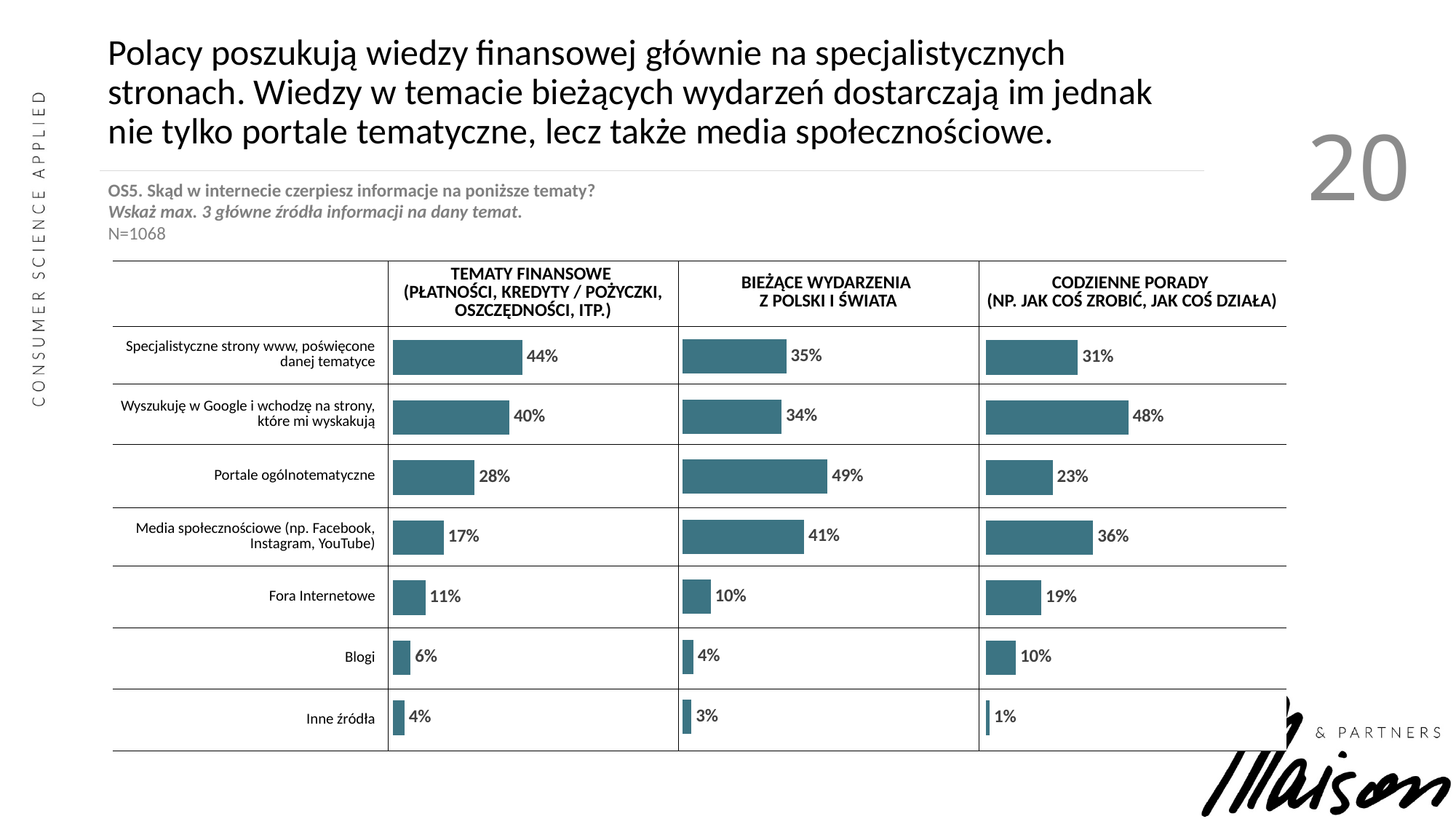
In the CODZIENNE PORADY chart, which is larger: Wyszukuję w Google i wchodzę na strony, które mi wyskakują or Specjalistyczne strony www? Wyszukuję w Google i wchodzę na strony, które mi wyskakują In the TEMATY FINANSOWE chart, what is the value for Specjalistyczne strony www, poświęcone danej tematyce? 44% What is the sample size (N) stated on the slide? N=1068 In the BIEŻĄCE WYDARZENIA Z POLSKI I ŚWIATA chart, which category has the highest value? Portale ogólnotematyczne How many categories are shown in each of the three charts? 7 In the TEMATY FINANSOWE chart, which category has the highest value? Specjalistyczne strony www, poświęcone danej tematyce In the CODZIENNE PORADY chart, what is the value for Fora Internetowe? 19% In the BIEŻĄCE WYDARZENIA Z POLSKI I ŚWIATA chart, what is the value for Media społecznościowe (np. Facebook, Instagram, YouTube)? 41% In the CODZIENNE PORADY chart, which category has the lowest value? Inne źródła What kind of chart is used in the TEMATY FINANSOWE column? Bar chart In the BIEŻĄCE WYDARZENIA Z POLSKI I ŚWIATA chart, what is the difference between Portale ogólnotematyczne and Blogi? 45% In the TEMATY FINANSOWE chart, what is the difference between Specjalistyczne strony www and Media społecznościowe? 27%